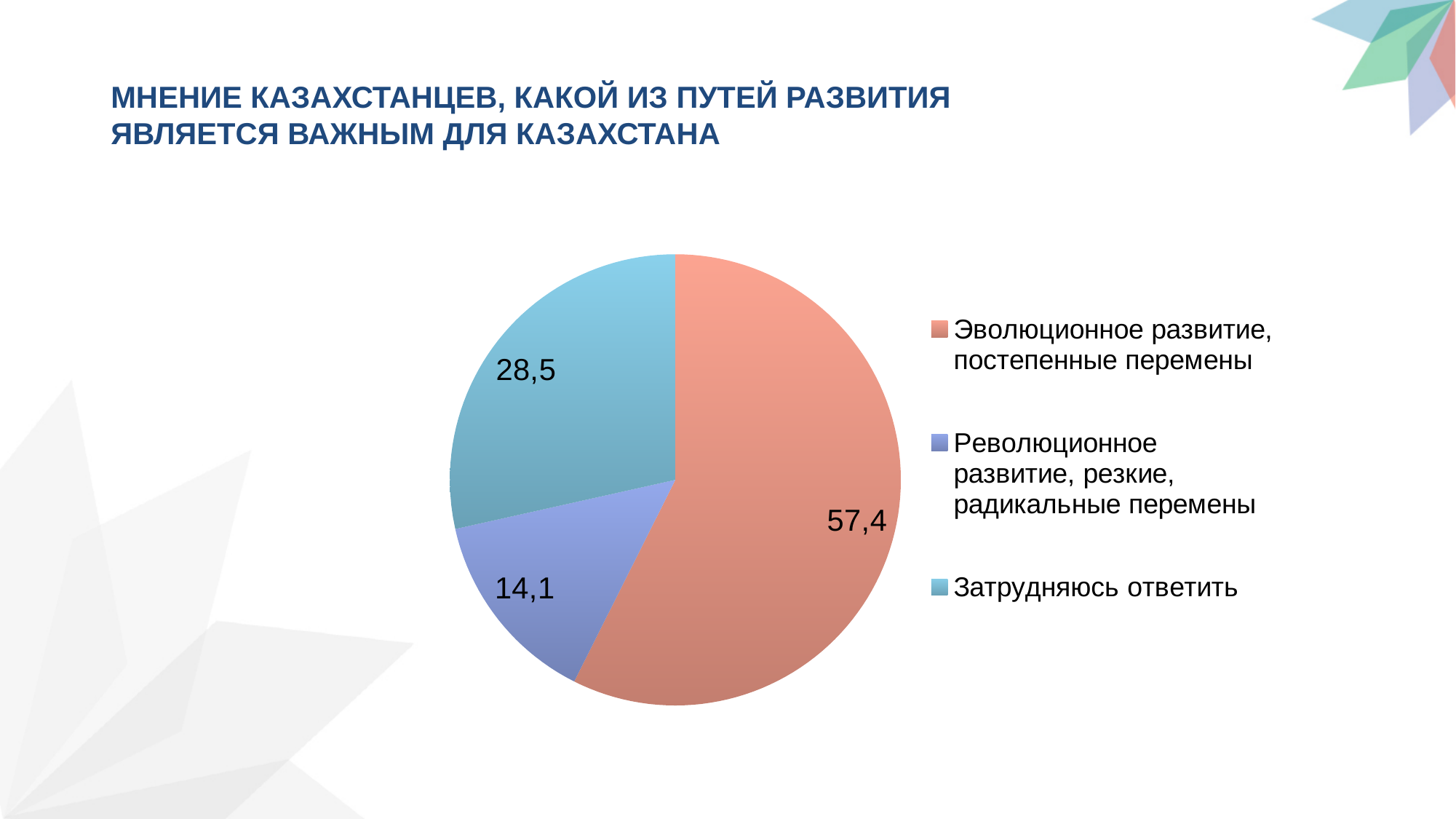
What is the title of the slide containing the chart? МНЕНИЕ КАЗАХСТАНЦЕВ, КАКОЙ ИЗ ПУТЕЙ РАЗВИТИЯ ЯВЛЯЕТСЯ ВАЖНЫМ ДЛЯ КАЗАХСТАНА What colour is the slice for "Затрудняюсь ответить"? light blue What is the value for "Затрудняюсь ответить"? 28,5 Which category has the largest slice of the pie? Эволюционное развитие, постепенные перемены What is the difference between the values for "Затрудняюсь ответить" and "Революционное развитие, резкие, радикальные перемены"? 14,4 How many slices does the pie chart have? 3 What is the value for "Революционное развитие, резкие, радикальные перемены"? 14,1 What is the value for "Эволюционное развитие, постепенные перемены"? 57,4 Which category has the smallest slice of the pie? Революционное развитие, резкие, радикальные перемены What is the difference between the values for "Эволюционное развитие, постепенные перемены" and "Революционное развитие, резкие, радикальные перемены"? 43,3 What type of chart is shown on the slide? pie chart Which is larger: the value for "Затрудняюсь ответить" or the value for "Революционное развитие, резкие, радикальные перемены"? Затрудняюсь ответить